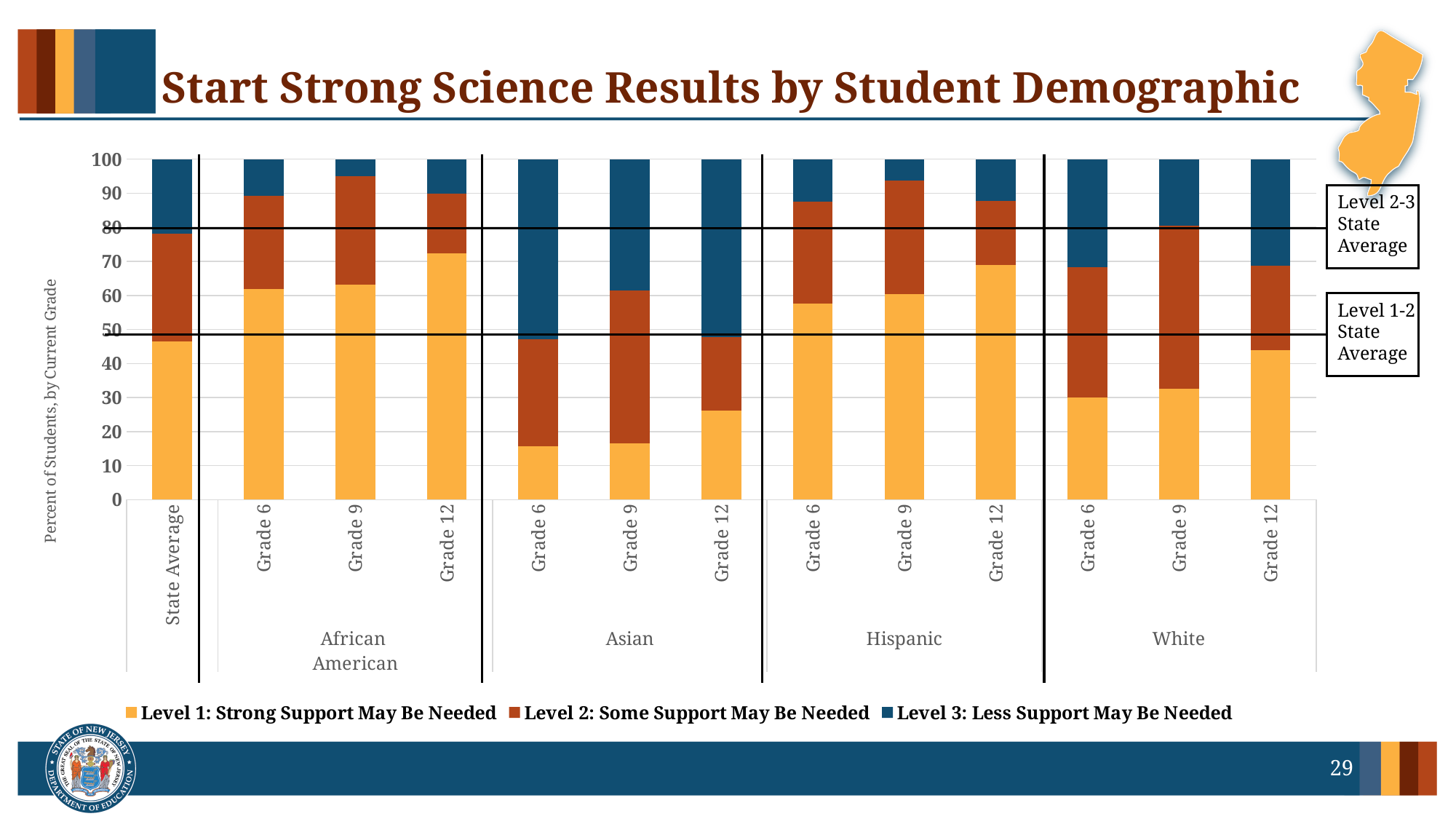
Which has the larger Level 1 segment, African American Grade 6 or Asian Grade 6? African American Grade 6 What kind of chart is shown on the slide? Stacked bar chart Is the Level 1 value for Asian Grade 12 greater or less than 20? greater How many bars are plotted in the chart? 13 Is the Level 1 value for African American Grade 12 greater or less than 70? greater How many series does the legend list? 3 Which has the larger Level 1 segment, Asian Grade 6 or White Grade 6? White Grade 6 What is the label on the vertical axis? Percent of Students, by Current Grade Is the Level 1 value for Asian Grade 6 greater or less than 20? less What is the total height of the State Average stacked bar? 100 Within the Asian group, does the Level 1 segment rise or fall from Grade 6 to Grade 12? Rise